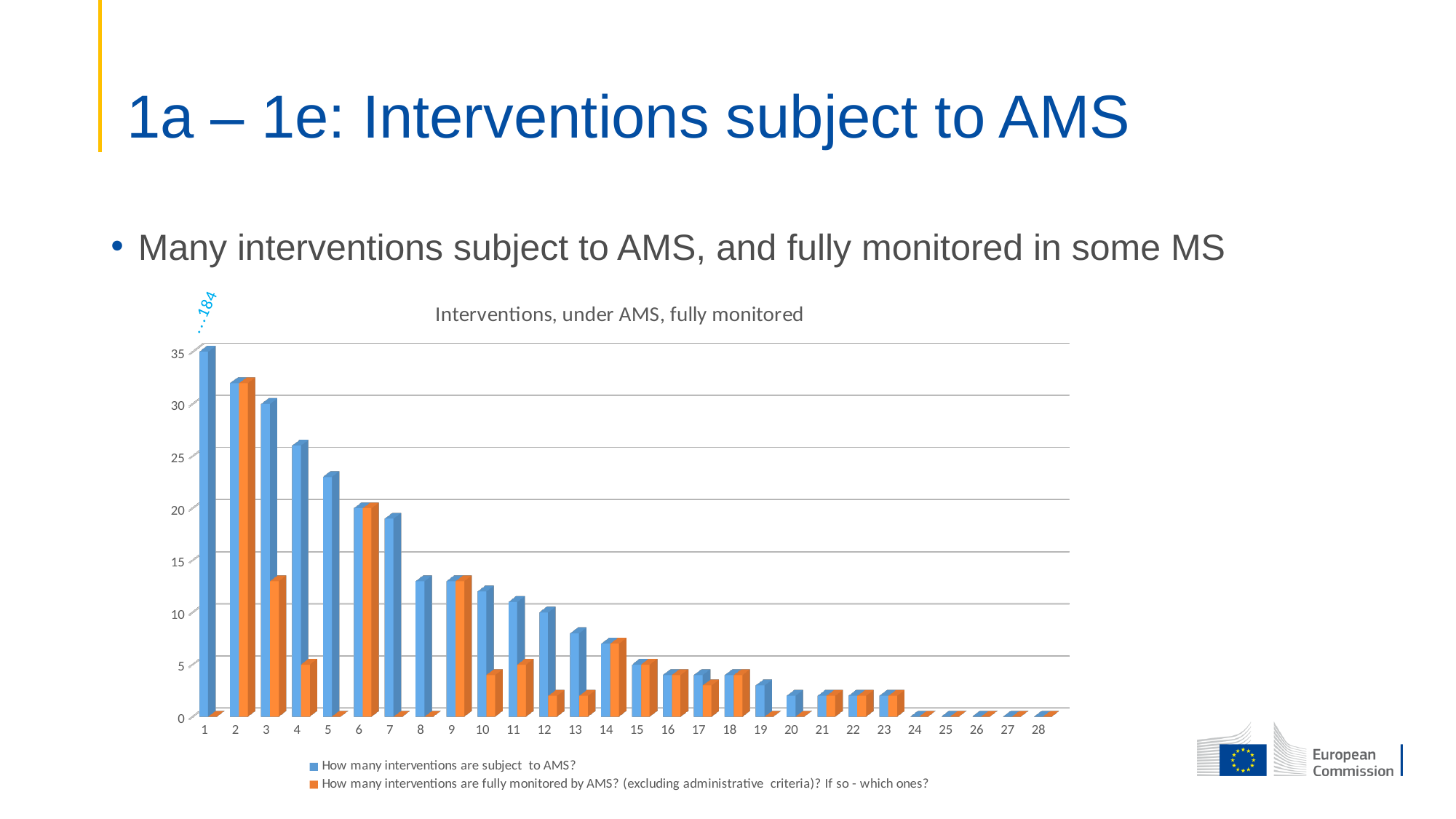
For category 3, which series has the larger value: 'How many interventions are subject to AMS?' or 'How many interventions are fully monitored by AMS?'? How many interventions are subject to AMS? Is the value for category 2 in the series 'How many interventions are subject to AMS?' greater or less than 30? greater How many series does the chart's legend list? 2 What kind of chart is shown on the slide? bar chart Is the value for category 5 in the series 'How many interventions are subject to AMS?' greater or less than 20? greater What value is written above the tallest bar in the chart (category 1)? 184 Is the value for category 3 in the series 'How many interventions are fully monitored by AMS?' greater or less than 10? greater How many categories are shown along the x axis of the chart? 28 Which category has the highest value for the series 'How many interventions are subject to AMS?'? 1 What is the title of the chart? Interventions, under AMS, fully monitored Do the values for the series 'How many interventions are subject to AMS?' rise or fall from category 1 to category 28? fall